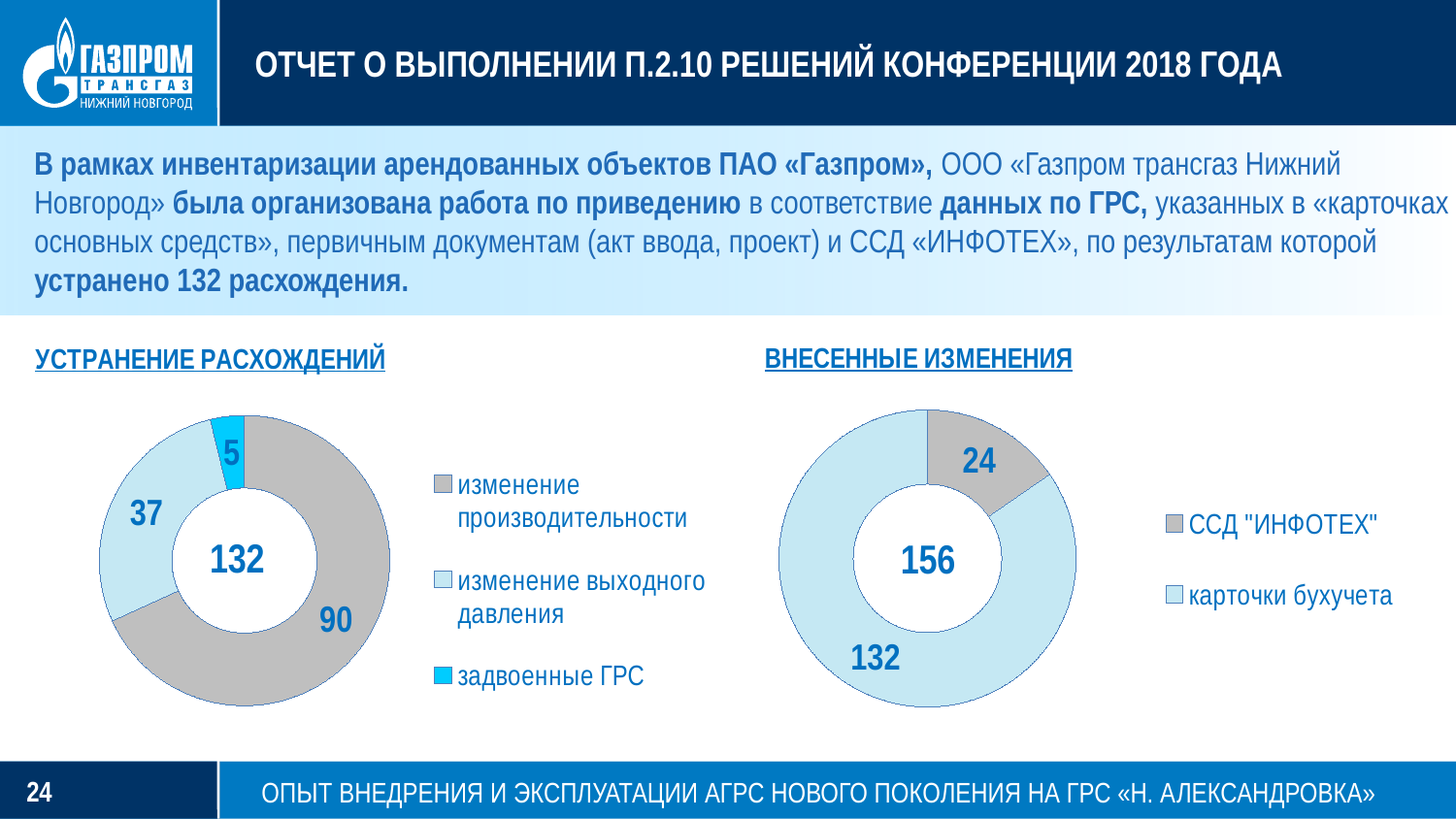
In the «УСТРАНЕНИЕ РАСХОЖДЕНИЙ» chart, what is the difference between «изменение производительности» and «изменение выходного давления»? 53 In the «УСТРАНЕНИЕ РАСХОЖДЕНИЙ» chart, what is the value for «изменение производительности»? 90 In the «ВНЕСЕННЫЕ ИЗМЕНЕНИЯ» chart, what is the value for «карточки бухучета»? 132 What type of chart is used under the heading «УСТРАНЕНИЕ РАСХОЖДЕНИЙ»? Doughnut (pie) chart What total is shown in the centre of the «ВНЕСЕННЫЕ ИЗМЕНЕНИЯ» chart? 156 In the «УСТРАНЕНИЕ РАСХОЖДЕНИЙ» chart, which category has the smallest value? задвоенные ГРС In the «УСТРАНЕНИЕ РАСХОЖДЕНИЙ» chart, what is the value for «изменение выходного давления»? 37 How many categories does the legend of the «УСТРАНЕНИЕ РАСХОЖДЕНИЙ» chart list? 3 In the «ВНЕСЕННЫЕ ИЗМЕНЕНИЯ» chart, what is the value for ССД «ИНФОТЕХ»? 24 In the «УСТРАНЕНИЕ РАСХОЖДЕНИЙ» chart, what is the value for «задвоенные ГРС»? 5 What total is shown in the centre of the «УСТРАНЕНИЕ РАСХОЖДЕНИЙ» chart? 132 In the «ВНЕСЕННЫЕ ИЗМЕНЕНИЯ» chart, which is larger: ССД «ИНФОТЕХ» or «карточки бухучета»? карточки бухучета